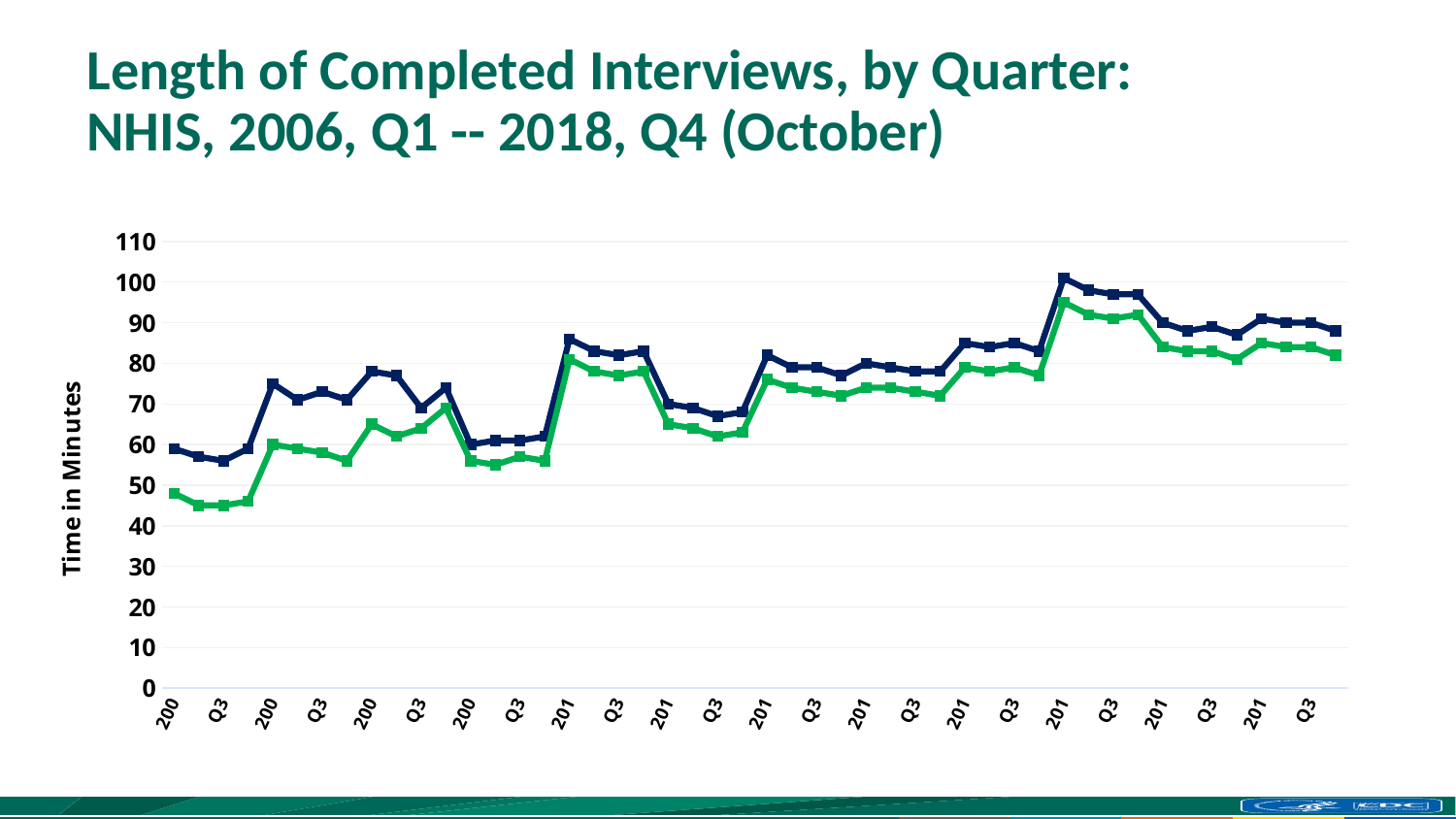
What is the title of the chart on the slide? Length of Completed Interviews, by Quarter: NHIS, 2006, Q1 -- 2018, Q4 (October) Is the highest value of the green line greater or less than 90? greater What kind of chart is shown on the slide? Line chart Is the highest value of the dark blue line greater or less than 90? greater What is the highest tick value shown on the vertical axis? 110 Is the leftmost value of the dark blue line greater or less than 70? less What is the label on the vertical axis of the chart? Time in Minutes Which line is higher across the chart, the dark blue line or the green line? The dark blue line Overall, do the values on the chart rise or fall from left to right along the x axis? Rise How many lines are plotted on the chart? 2